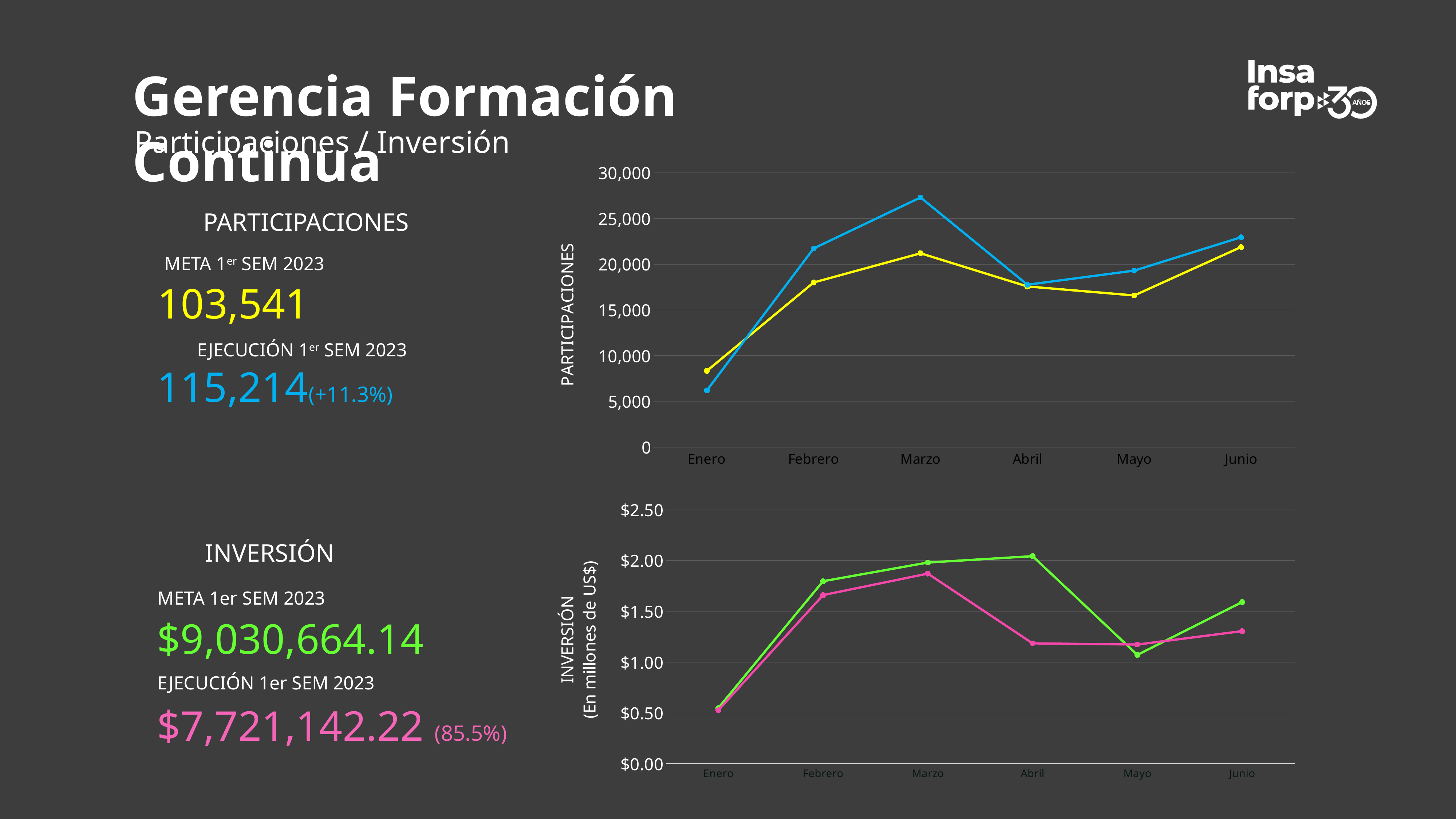
What unit is given in the y-axis label of the bottom INVERSIÓN chart? En millones de US$ In the top PARTICIPACIONES chart, does the blue line rise or fall from Marzo to Abril? Fall In the bottom INVERSIÓN chart, is the pink line's value for Abril greater or less than $1.50? less In the top PARTICIPACIONES chart, in which month is the blue line at its lowest? Enero What kind of chart is the top chart labelled PARTICIPACIONES? Line chart In the top PARTICIPACIONES chart, which line is higher in Febrero, the blue line or the yellow line? Blue line What kind of chart is the bottom chart labelled INVERSIÓN? Line chart In the top PARTICIPACIONES chart, is the yellow line's value for Enero greater or less than 10,000? less How many months are shown on the x axis of the top PARTICIPACIONES chart? 6 In the top PARTICIPACIONES chart, is the blue line's value for Marzo greater or less than 25,000? greater In the top PARTICIPACIONES chart, in which month does the blue line reach its highest point? Marzo In the bottom INVERSIÓN chart, in which month does the green line reach its highest point? Abril